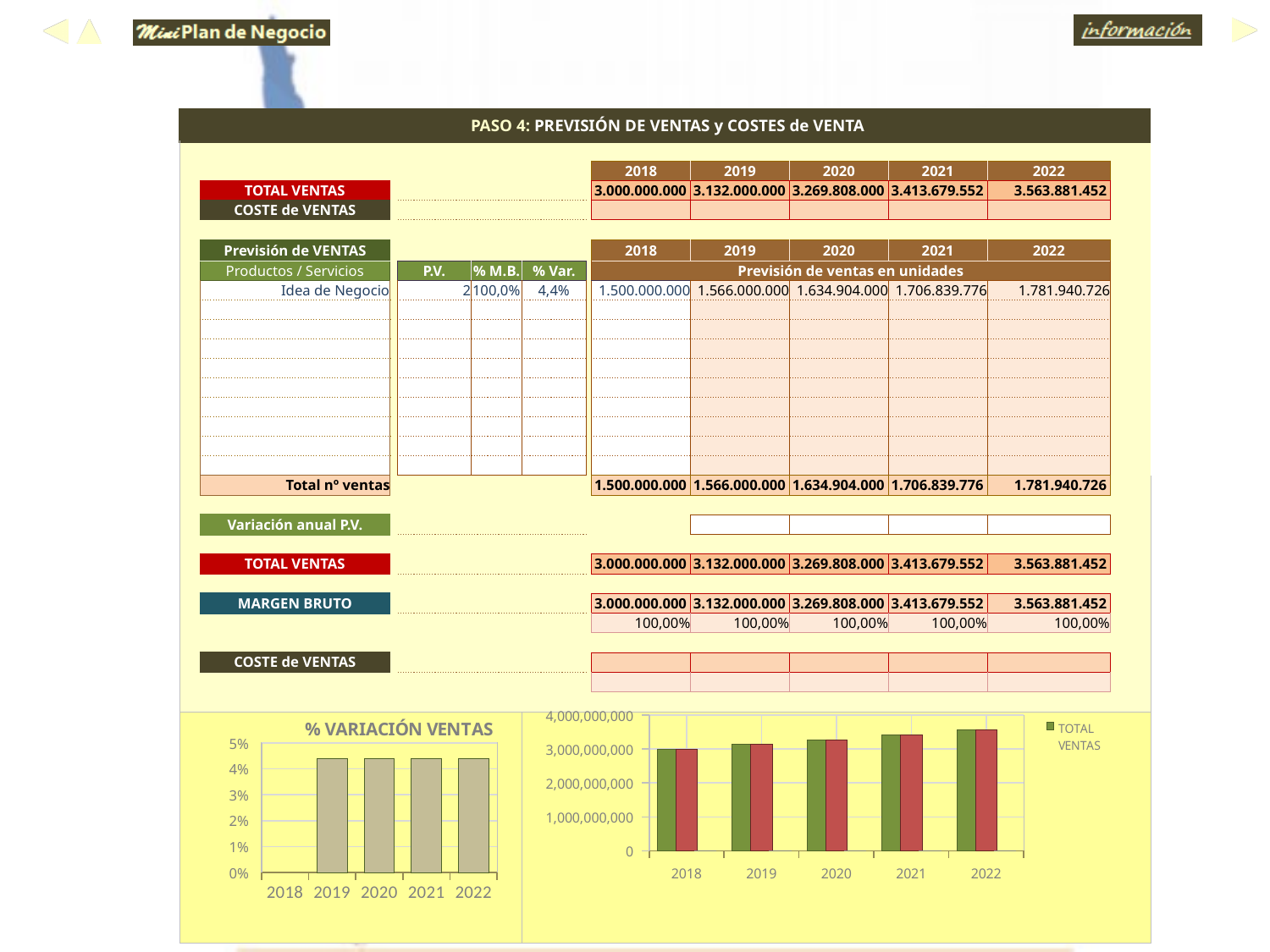
In the '% VARIACIÓN VENTAS' chart, is the value for 2020 greater or less than 4%? greater What is the legend entry of the right-hand chart? TOTAL VENTAS How many entries does the legend of the right-hand chart list? 1 How many years are shown on the x axis of the '% VARIACIÓN VENTAS' chart? 5 In the right-hand chart, do the values rise or fall from 2018 to 2022? rise What kind of chart is the '% VARIACIÓN VENTAS' chart on the left? bar chart In the '% VARIACIÓN VENTAS' chart, which year has no bar plotted? 2018 What kind of chart is the chart on the right of the slide (with the TOTAL VENTAS legend)? bar chart In the right-hand chart, is the value for 2022 greater or less than 4,000,000,000? less In the '% VARIACIÓN VENTAS' chart, is the value for 2022 greater or less than 5%? less In the right-hand chart, which year has the highest bars? 2022 In the right-hand chart, which year has the lowest bars? 2018